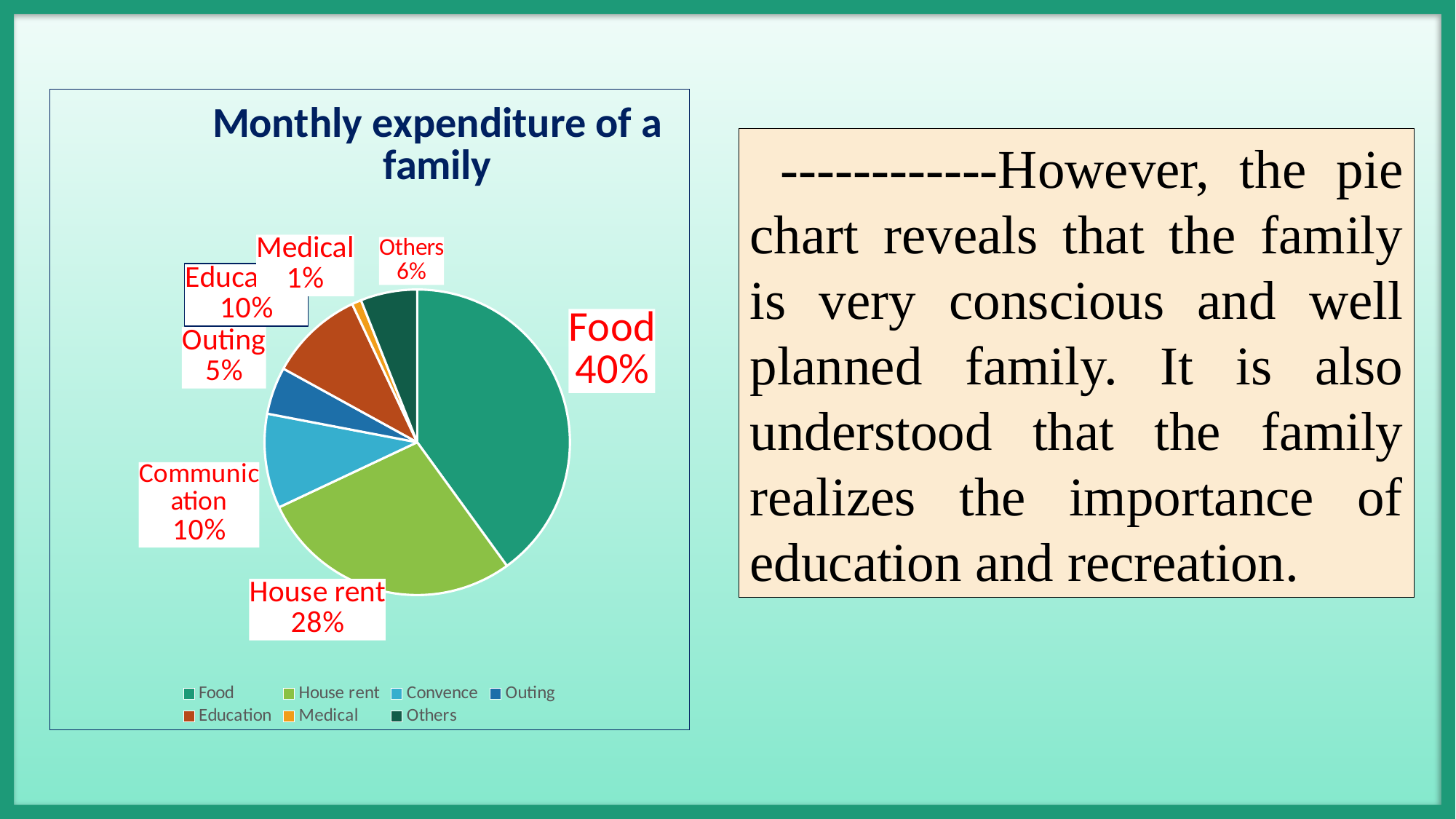
Which is larger, the share for Others or the share for Outing? Others What share of the pie is labelled Medical? 1% What percentage of the monthly expenditure goes to House rent? 28% How much larger is the Food share than the House rent share? 12% Which category has the largest slice of the pie? Food What share of the pie is labelled Others? 6% What is the title of the chart? Monthly expenditure of a family What type of chart is shown on the slide? pie chart How many entries does the legend list? 7 What percentage is shown for Outing? 5% What percentage of the monthly expenditure goes to Food? 40% Which category has the smallest slice of the pie? Medical